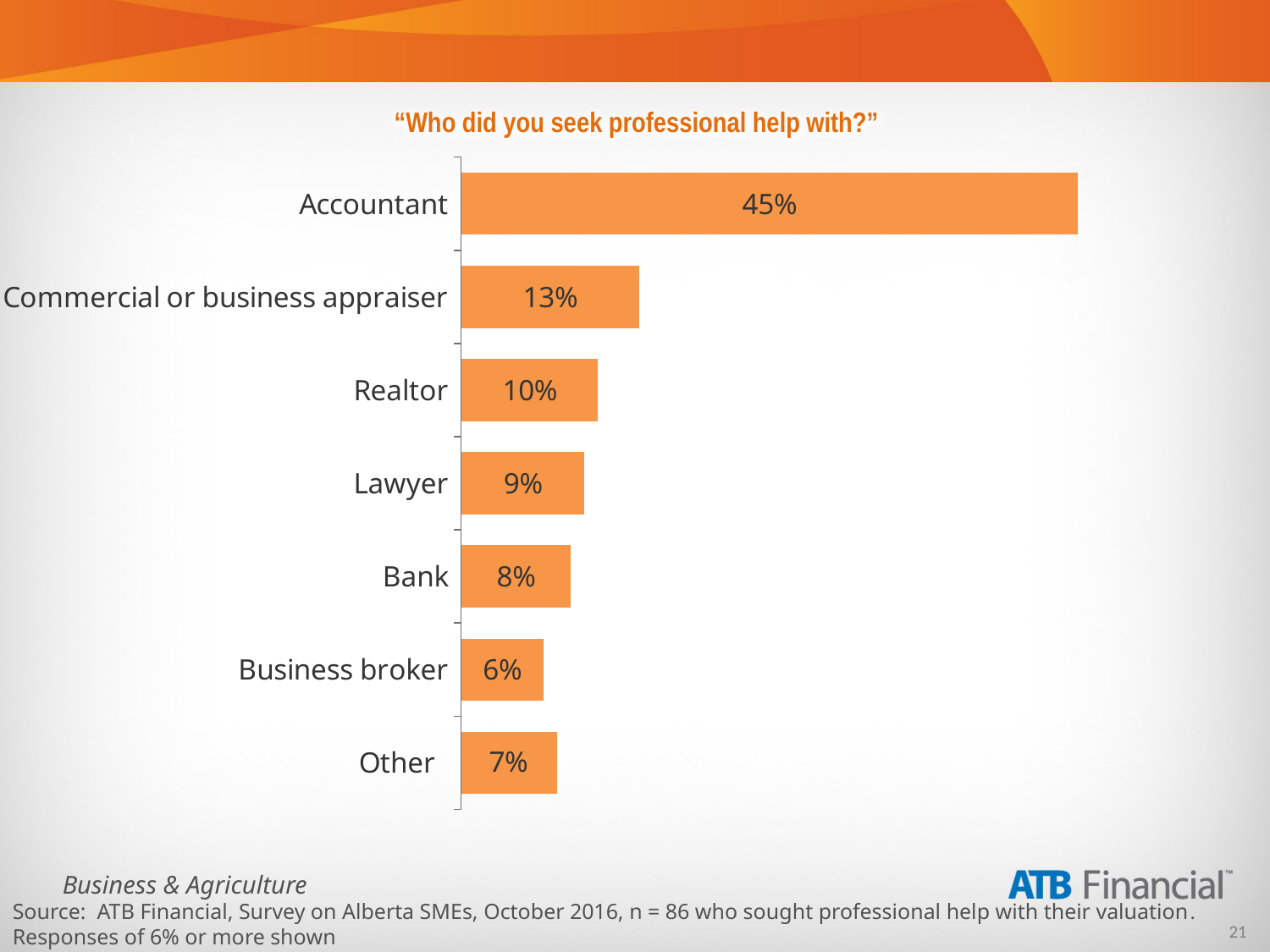
What is the difference between the values for Accountant and Commercial or business appraiser? 32% What is the value shown for Commercial or business appraiser? 13% What is the title of the chart? "Who did you seek professional help with?" What is the difference between the values for Lawyer and Bank? 1% What is the value for Bank? 8% What kind of chart is shown on the slide? Bar chart What percentage is shown for Realtor? 10% Which category has the highest value? Accountant What percentage of respondents sought professional help from an accountant? 45% Which category has the lowest value? Business broker Which is larger, the value for Other or the value for Business broker? Other How many categories are shown in the chart? 7